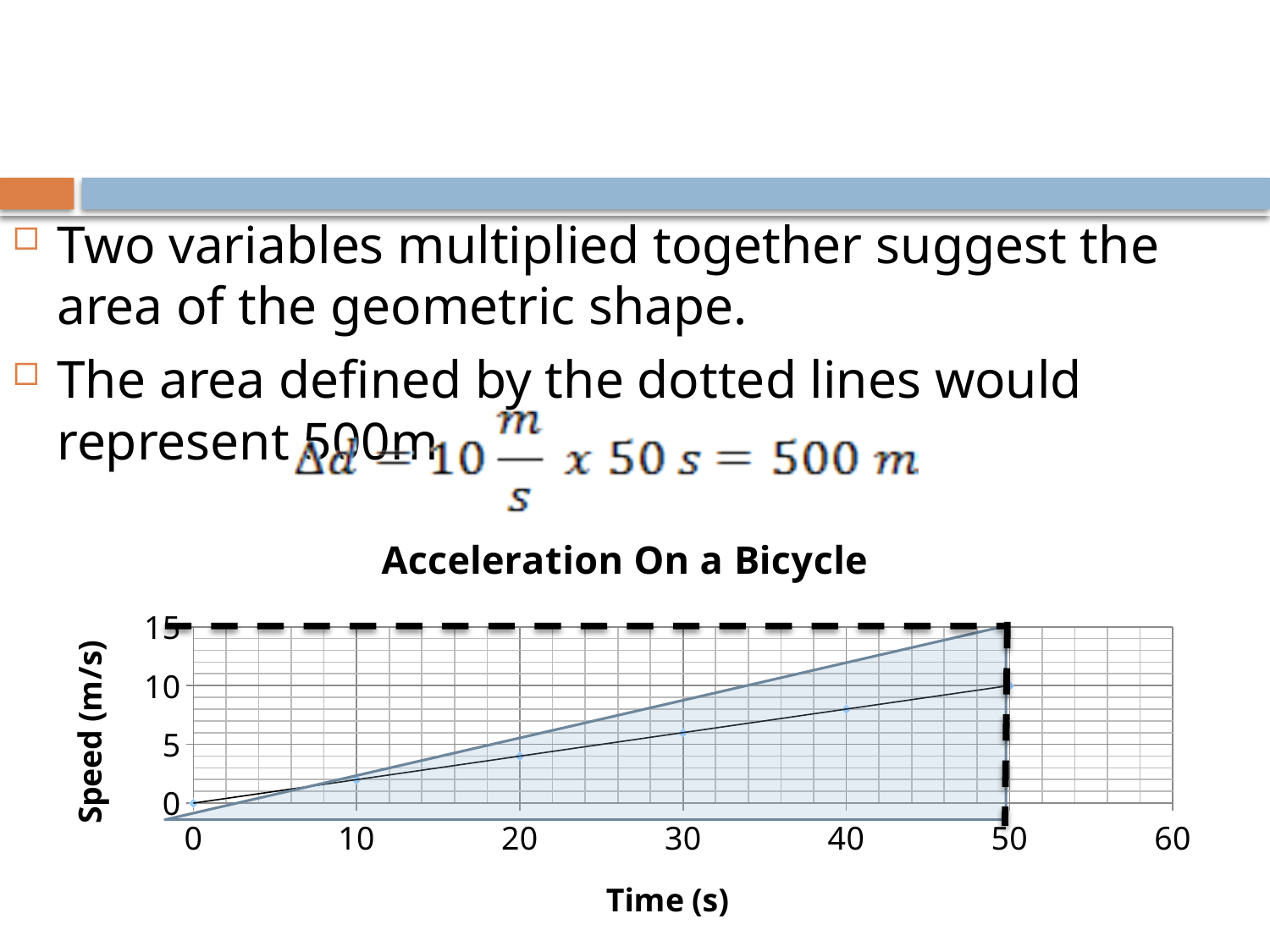
Which time has the highest speed on the plotted line, 10 s or 50 s? 50 s Does the speed rise or fall as time increases along the x axis? rise What is the speed at a time of 50 s on the plotted line? 10 What is the title of the chart? Acceleration On a Bicycle Is the speed at 40 s greater or less than 10? less Is the speed at 20 s greater or less than 5? less What is the highest value shown on the x axis? 60 What is the label of the y axis of the chart? Speed (m/s) What is the speed at a time of 0 s on the plotted line? 0 What kind of chart is shown on the slide? line chart Is the speed at 30 s greater or less than 5? greater How many data points are plotted on the line? 6